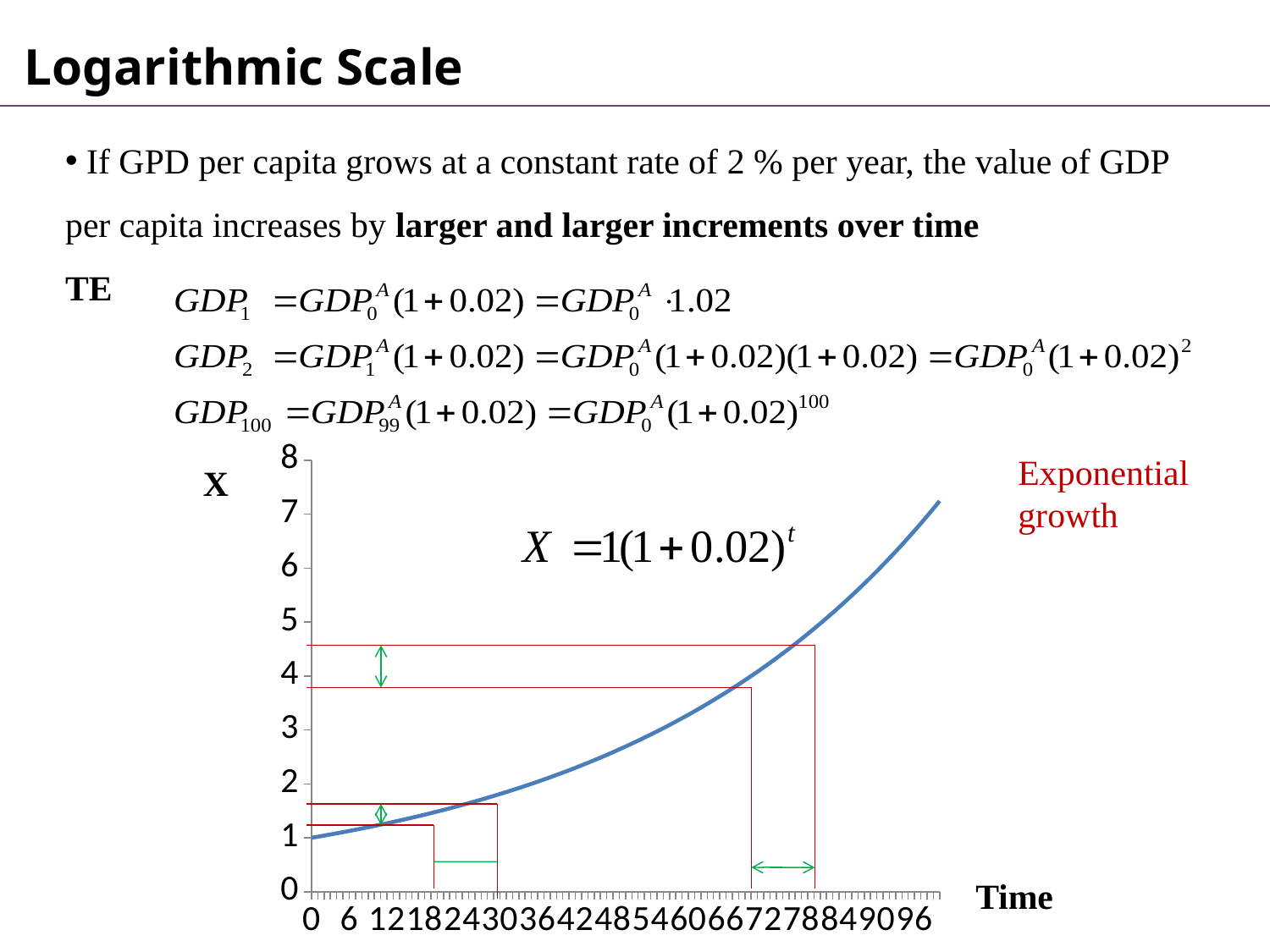
Is the value of X at Time 24 greater or less than 2? less Does the value of X rise or fall as Time increases along the x axis? rise Is the value of X at Time 72 greater or less than 5? less Is the value of X at Time 96 greater or less than 6? greater How many lines (series) are plotted on the chart? 1 What is the label of the horizontal axis of the chart? Time What is the highest tick value shown on the vertical axis of the chart? 8 What kind of chart is shown on the slide? line chart What is the value of X at Time 0 on the chart? 1